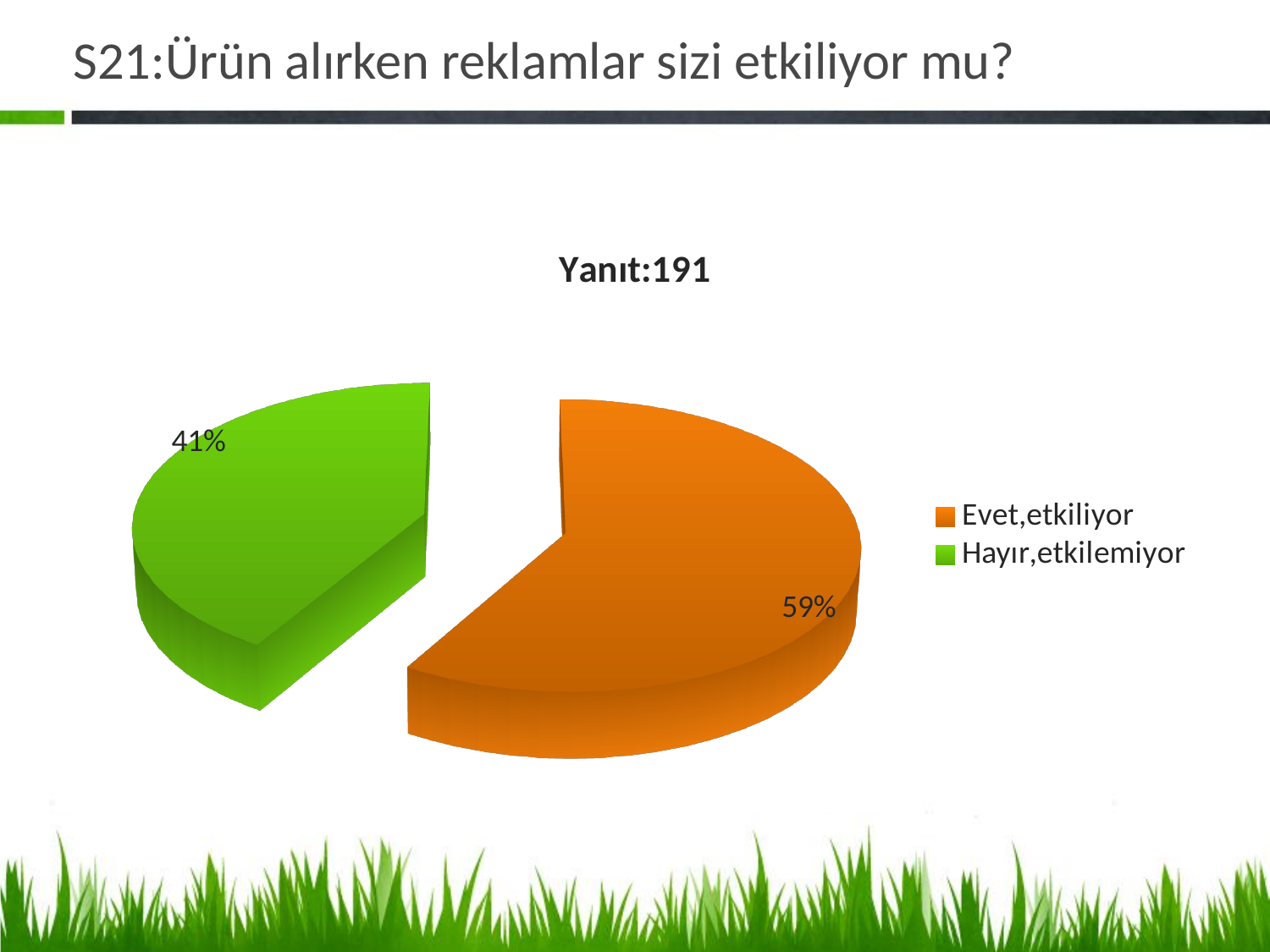
What is the title of the chart? Yanıt:191 How many entries does the legend list? 2 What share of the pie does "Evet,etkiliyor" have? 59% What share of the pie does "Hayır,etkilemiyor" have? 41% What colour is the "Hayır,etkilemiyor" slice? green Which category has the largest slice of the pie? Evet,etkiliyor How many slices does the pie chart have? 2 What is the difference in percentage points between the "Evet,etkiliyor" and "Hayır,etkilemiyor" slices? 18 Which category has the smallest slice of the pie? Hayır,etkilemiyor Which is larger, the "Evet,etkiliyor" slice or the "Hayır,etkilemiyor" slice? Evet,etkiliyor What kind of chart is shown on the slide? pie chart